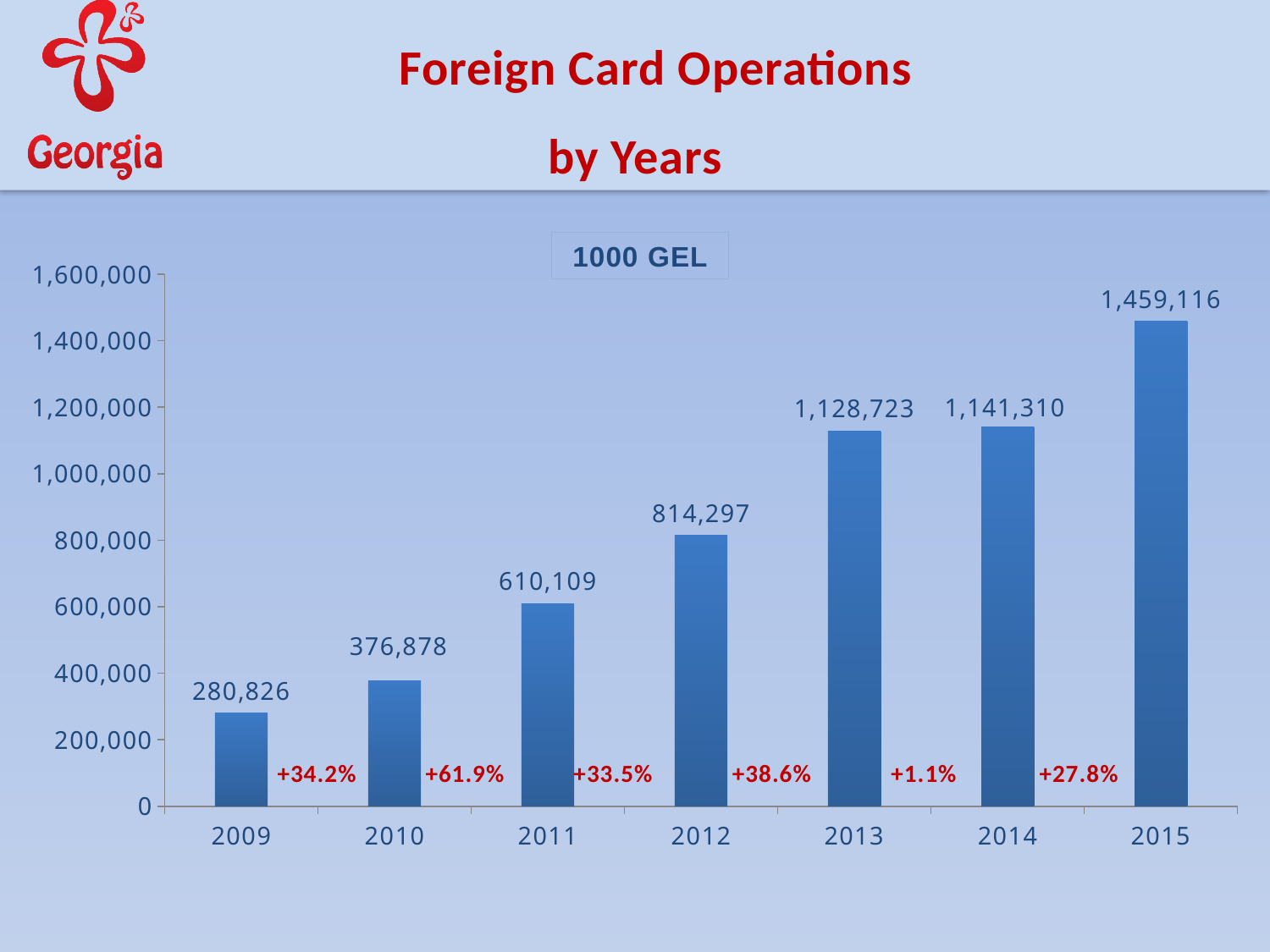
Do the values rise or fall from 2009 to 2015? rise Is the value for 2011 greater or less than 800,000? less What is the value for 2009? 280,826 Which year has the highest value? 2015 Which year has the lowest value? 2009 What is the difference between the values for 2015 and 2014? 317,806 How many years are shown on the x axis? 7 What kind of chart is shown on the slide? bar chart What is the value for 2012? 814,297 Which is larger, the value for 2012 or the value for 2013? 2013 What is the value for 2015? 1,459,116 What is the difference between the values for 2011 and 2010? 233,231